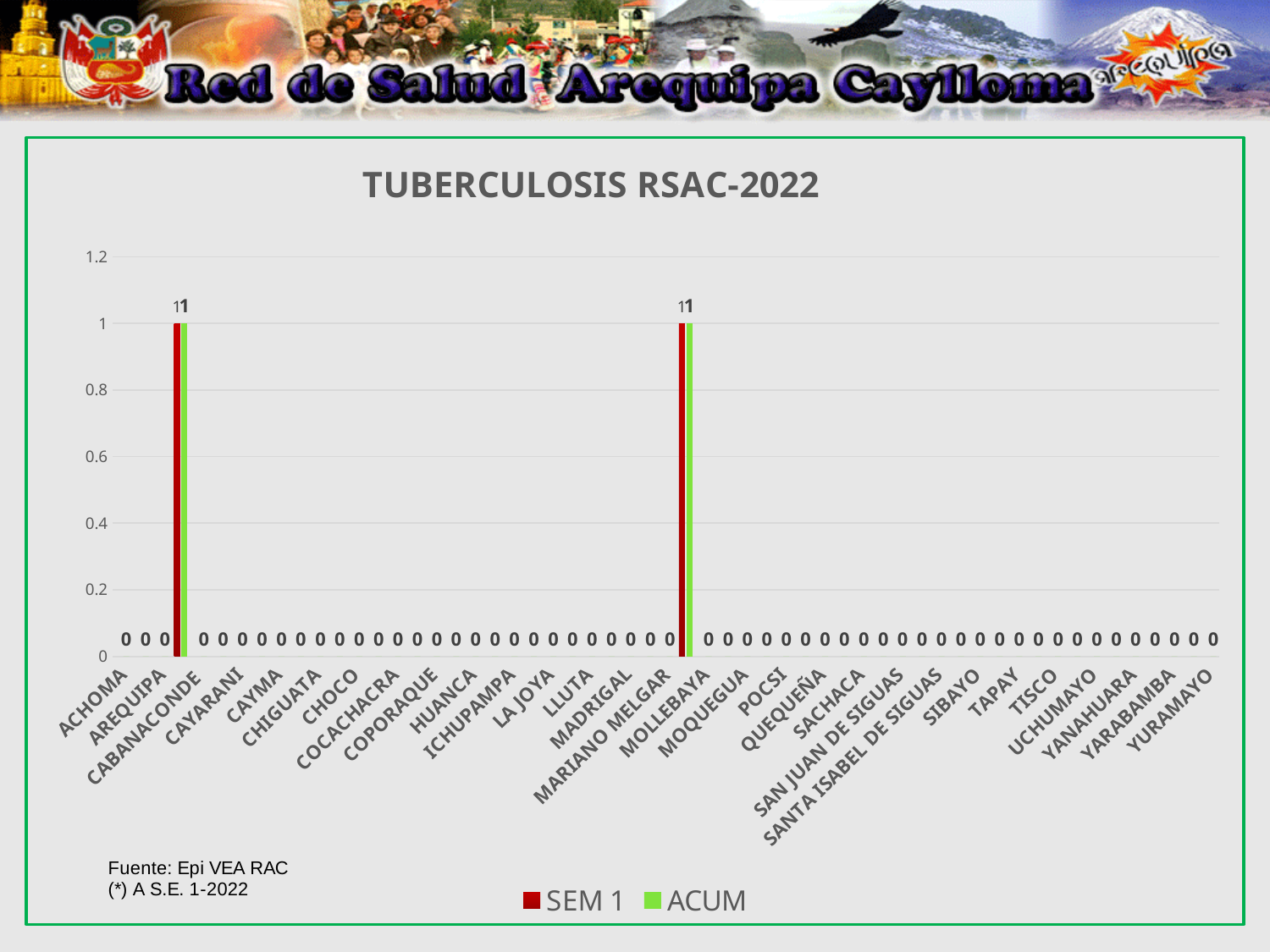
How many series does the legend list? 2 What is the title of the chart? TUBERCULOSIS RSAC-2022 What kind of chart is shown on the slide? Bar chart What are the two series named in the legend? SEM 1 and ACUM What is the ACUM value for SACHACA? 0